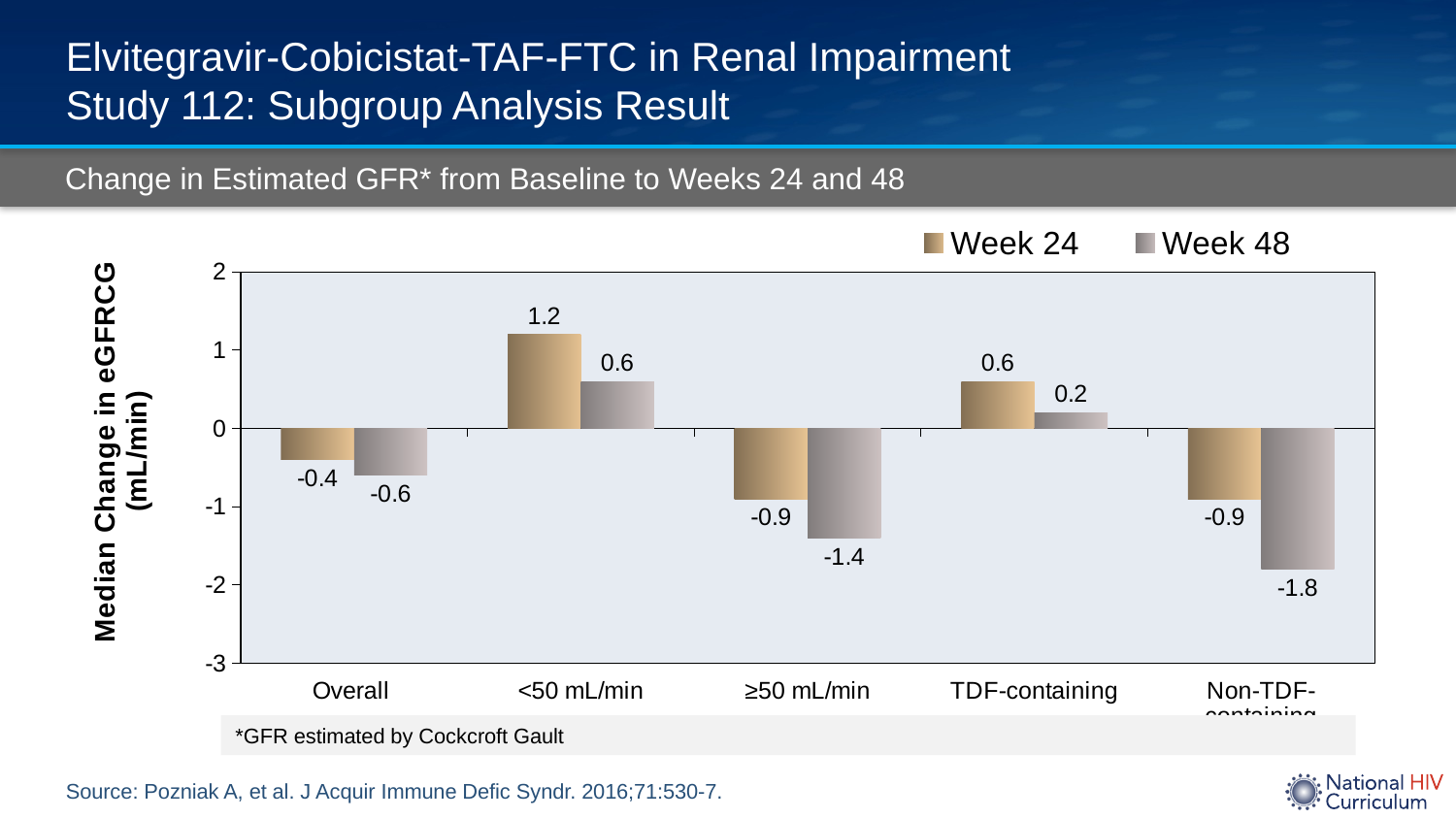
What kind of chart is shown on the slide? Bar chart What is the Week 24 value for the <50 mL/min subgroup? 1.2 How many series does the legend list? 2 What is the Week 48 value for the Non-TDF-containing subgroup? -1.8 Which is larger for the TDF-containing subgroup, the Week 24 value or the Week 48 value? Week 24 What is the difference between the Week 24 and Week 48 values for the ≥50 mL/min subgroup? 0.5 What is the Week 48 value for the Overall group? -0.6 How many subgroups are shown on the x axis? 5 Which subgroup has the lowest Week 48 value? Non-TDF-containing Which subgroup has the highest Week 24 value? <50 mL/min What is the Week 24 value for the TDF-containing subgroup? 0.6 What is the y-axis label of the chart? Median Change in eGFRCG (mL/min)